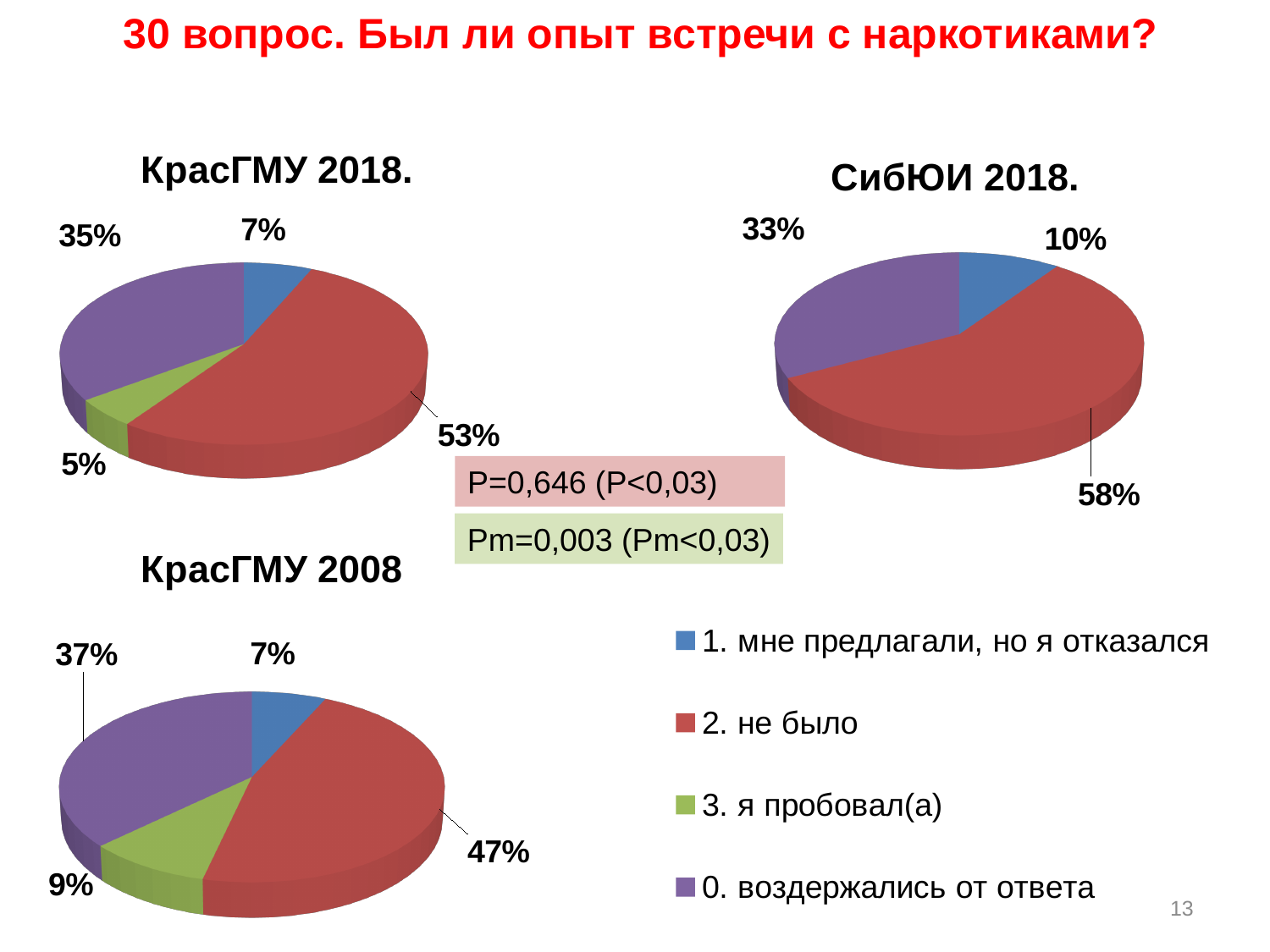
Which is larger: the "0. воздержались от ответа" share in КрасГМУ 2018 or in КрасГМУ 2008? КрасГМУ 2008 In the КрасГМУ 2008 pie chart, what is the difference between the "2. не было" share and the "0. воздержались от ответа" share? 10% In the СибЮИ 2018 pie chart, what share is shown for "1. мне предлагали, но я отказался"? 10% What colour represents "2. не было" in the legend? Red In the СибЮИ 2018 pie chart, which category has the largest share? 2. не было In the КрасГМУ 2018 pie chart, what is the combined share of "1. мне предлагали, но я отказался" and "3. я пробовал(а)"? 12% In the КрасГМУ 2018 pie chart, what share is labelled for the "2. не было" slice? 53% What type of chart is used for КрасГМУ 2018? Pie chart In the КрасГМУ 2018 pie chart, which category has the smallest share? 3. я пробовал(а) How many categories does the legend list? 4 In the КрасГМУ 2008 pie chart, what share is shown for "3. я пробовал(а)"? 9% How many slices does the СибЮИ 2018 pie chart have? 3